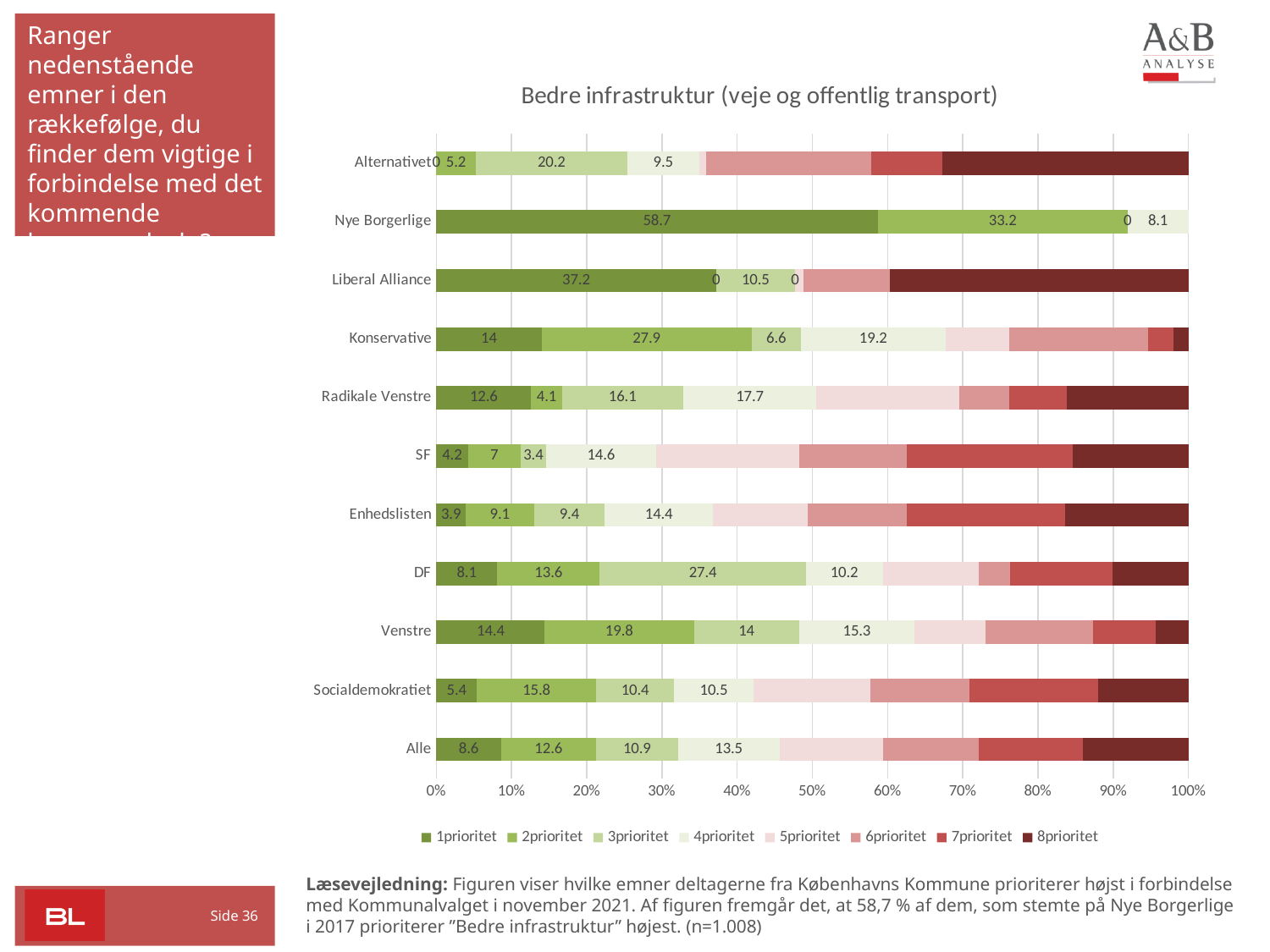
What is the 1prioritet value for Nye Borgerlige? 58.7 Which is larger, the 2prioritet value for Venstre or the 2prioritet value for Socialdemokratiet? Venstre What is the title of the chart? Bedre infrastruktur (veje og offentlig transport) What kind of chart is shown on the slide? Stacked bar chart What is the 3prioritet value for DF? 27.4 What is the 2prioritet value for Konservative? 27.9 How many categories are shown on the y axis? 11 What is the difference between the 1prioritet values for Nye Borgerlige and Liberal Alliance? 21.5 Which category has the lowest 1prioritet value? Alternativet Which category has the highest 1prioritet value? Nye Borgerlige How many series does the legend list? 8 What is the 4prioritet value for Alle? 13.5